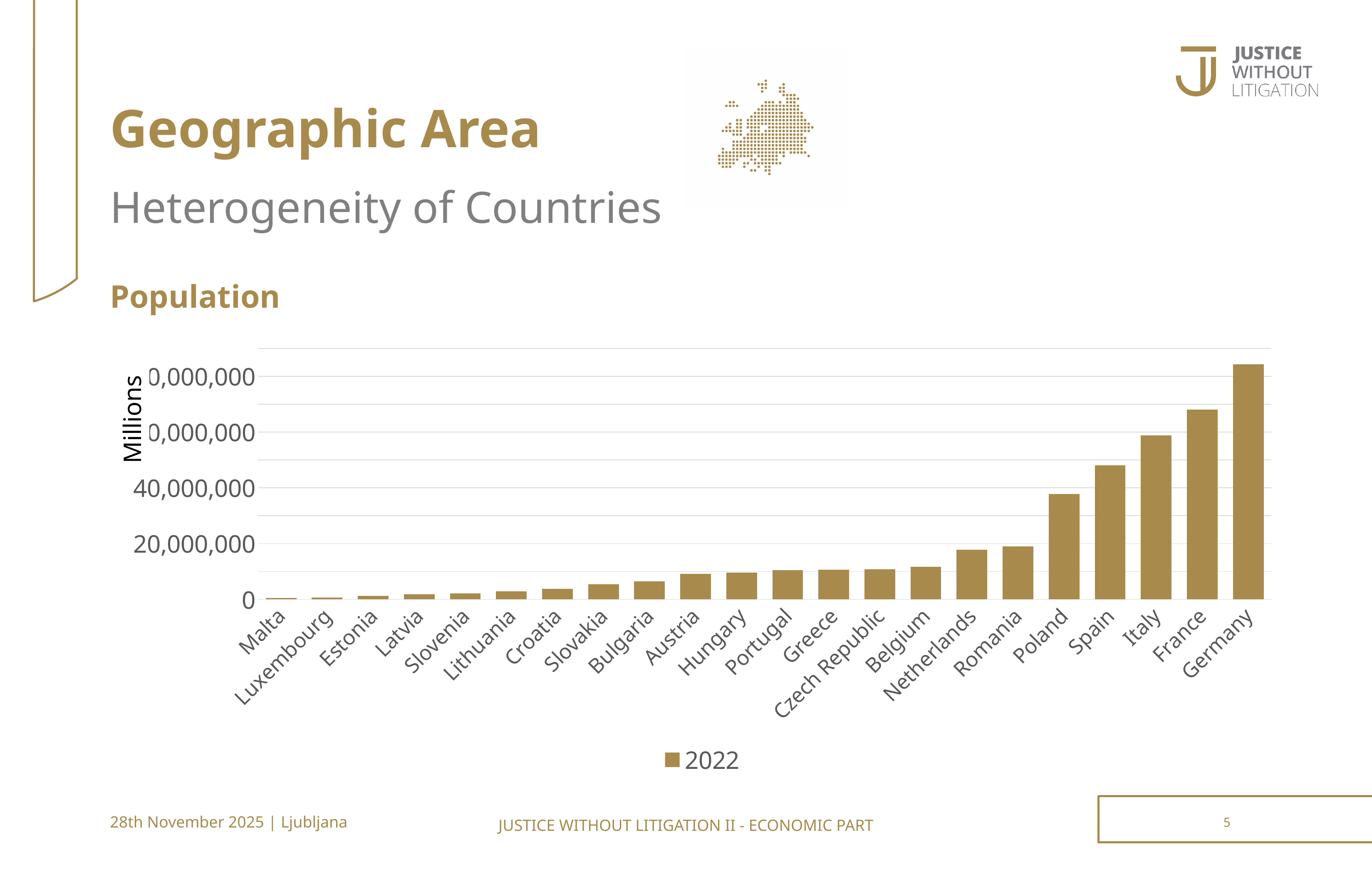
Which country has the lowest population in the chart? Malta What year does the legend entry of the chart refer to? 2022 What kind of chart is shown on the slide? bar chart How many countries are shown on the x axis of the Population chart? 22 Is the value for Spain greater or less than 40,000,000? greater Which has the larger population, Bulgaria or Slovakia? Bulgaria Which country has the highest population in the chart? Germany Is the value for Poland greater or less than 40,000,000? less Do the values rise or fall moving from left to right along the x axis? rise How many series does the legend of the Population chart list? 1 Which has the larger population, France or Italy? France Is the value for Netherlands greater or less than 20,000,000? less